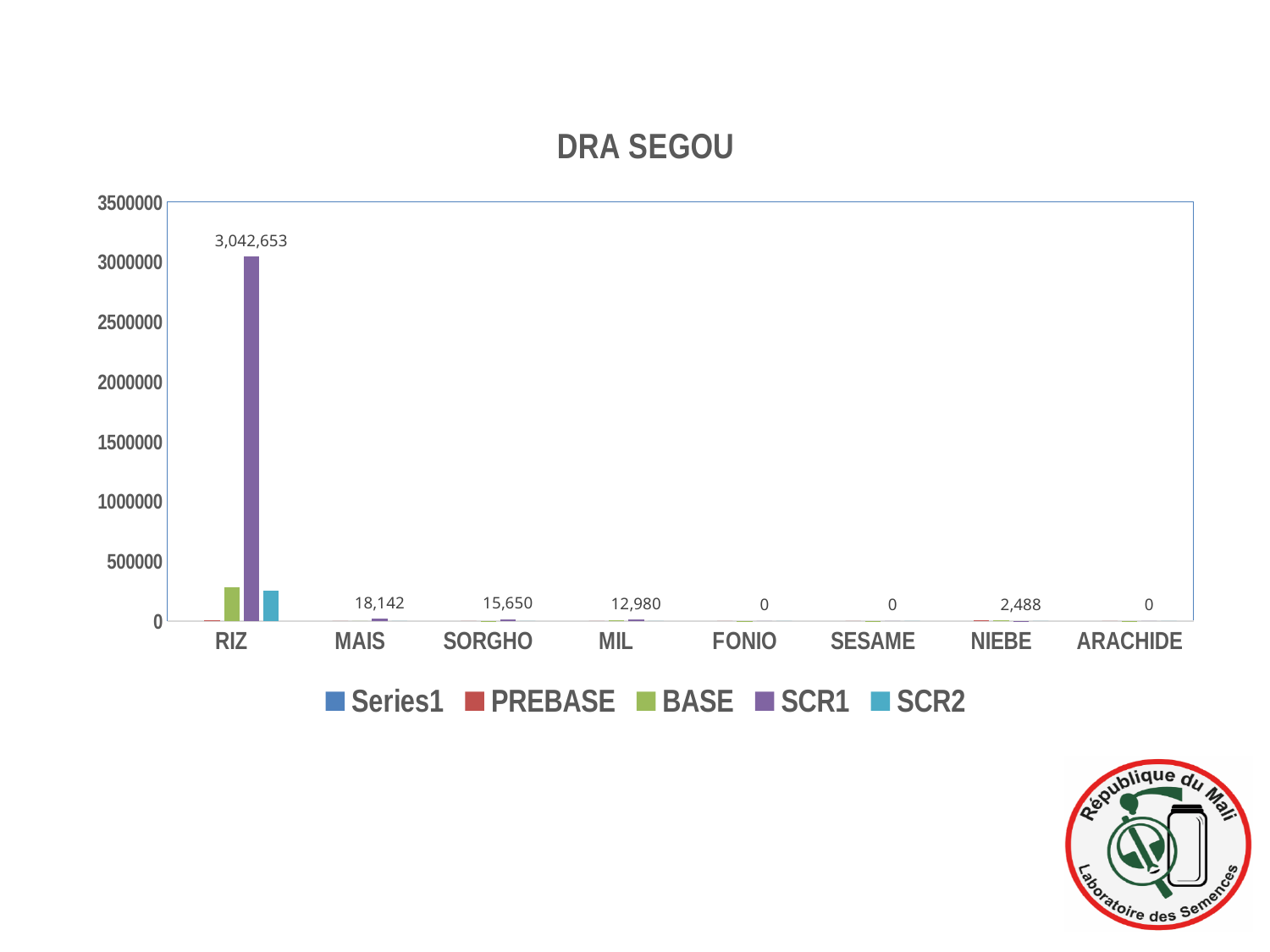
How many series does the legend list? 5 What is the difference between the SCR1 values for MAIS and SORGHO? 2,492 What is the SCR1 value for NIEBE? 2,488 Which category has the highest SCR1 value? RIZ How many categories are shown on the x axis? 8 What is the SCR1 value for SORGHO? 15,650 Which has a larger SCR1 value, MIL or NIEBE? MIL Is the BASE value for RIZ greater or less than 500000? less What kind of chart is shown on the slide? bar chart What is the SCR1 value for MAIS? 18,142 What is the title of the chart? DRA SEGOU What is the SCR1 value for RIZ? 3,042,653